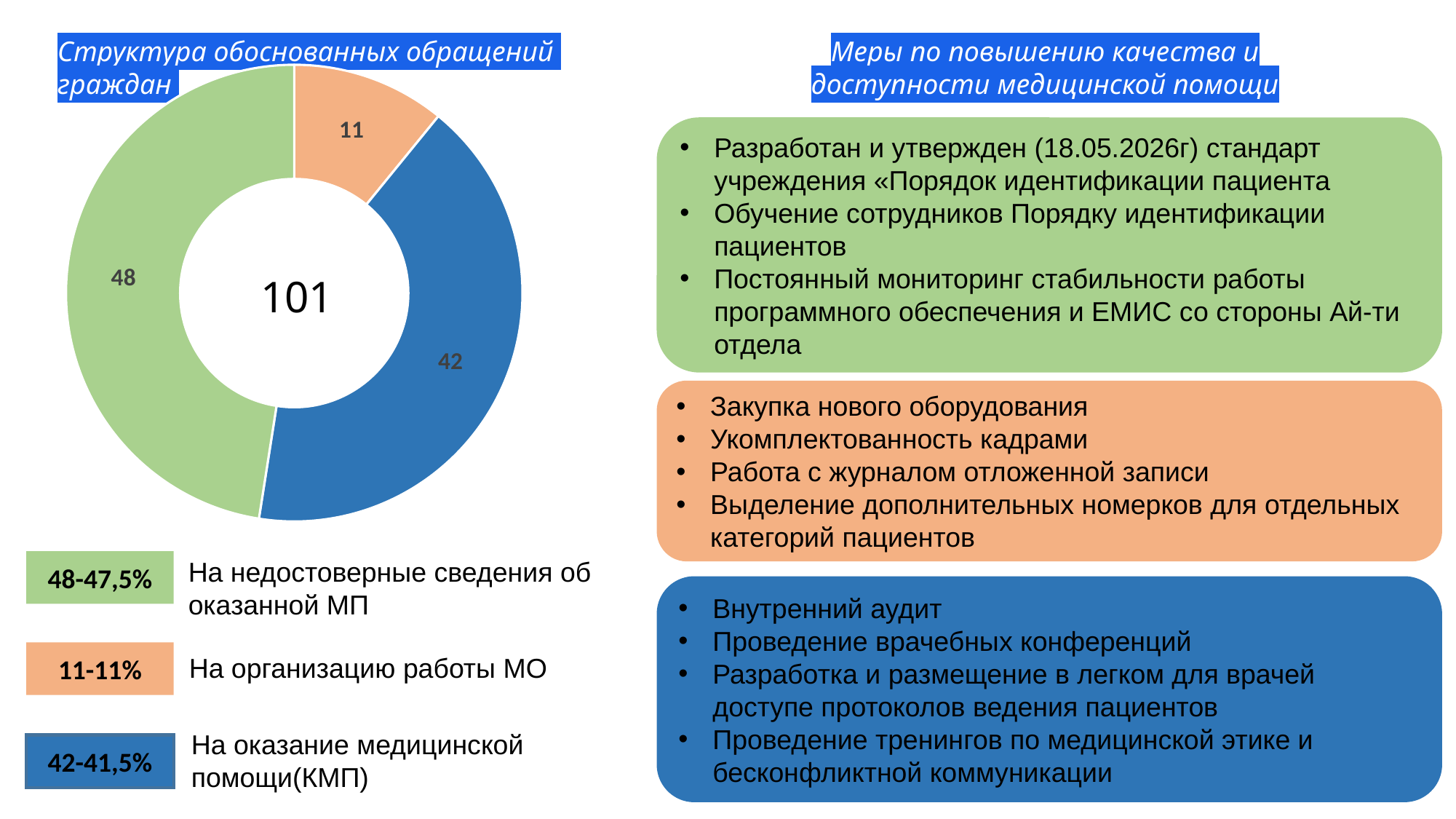
Which colour represents 'На организацию работы МО' in the donut chart? Orange What is the value for the segment 'На организацию работы МО'? 11 What type of chart is shown on the slide? Donut (pie) chart What is the value for the segment 'На недостоверные сведения об оказанной МП'? 48 Which category has the largest segment in the donut chart? На недостоверные сведения об оказанной МП How many segments does the donut chart have? 3 What is the value for the segment 'На оказание медицинской помощи(КМП)'? 42 Which category has the smallest segment in the donut chart? На организацию работы МО What total number is shown in the centre of the donut chart? 101 What is the difference between the values for 'На недостоверные сведения об оказанной МП' and 'На оказание медицинской помощи(КМП)'? 6 What share of the chart does the segment 'На оказание медицинской помощи(КМП)' represent, as shown in the legend? 41,5% What is the title of the chart on the slide? Структура обоснованных обращений граждан